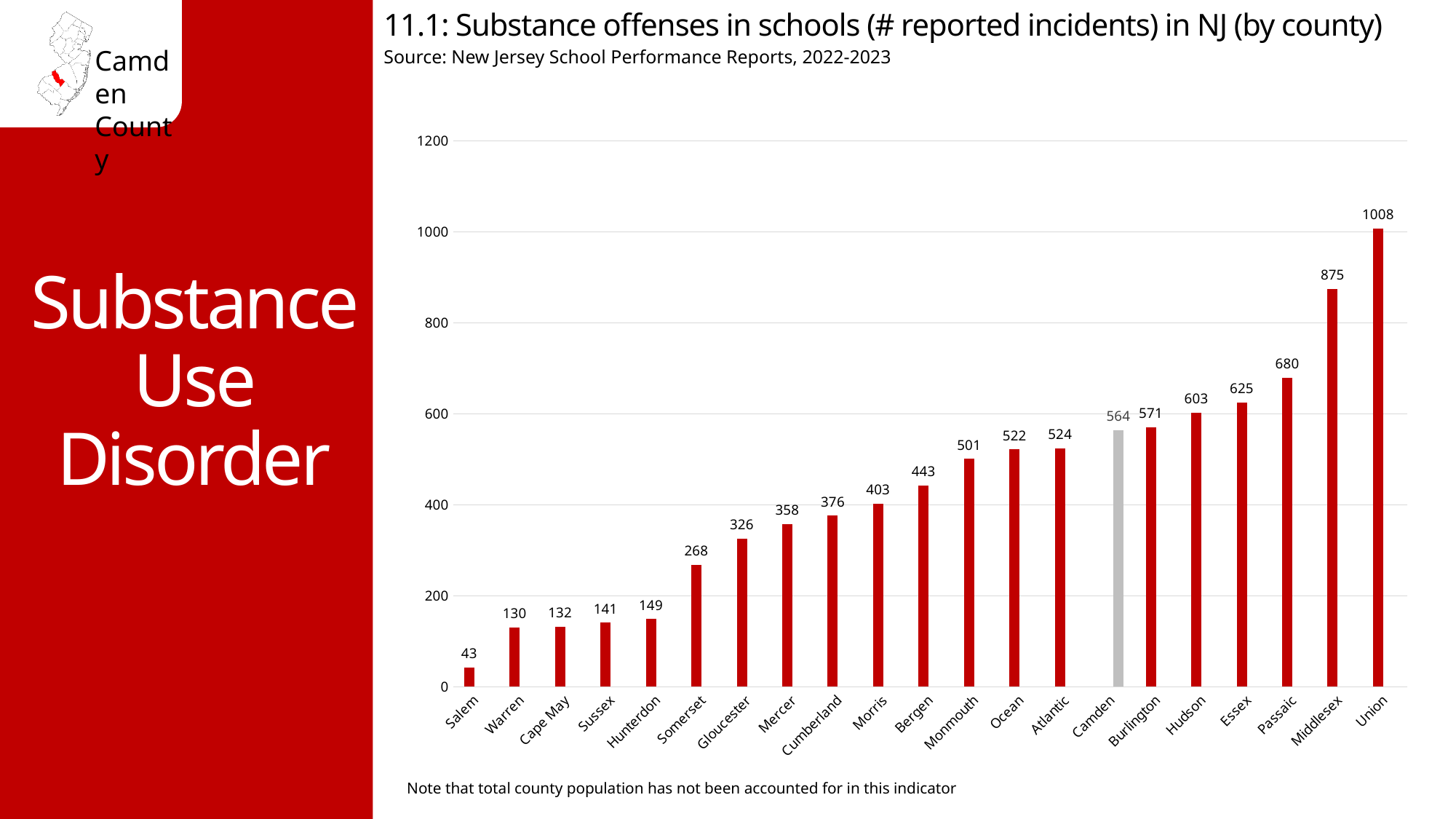
What kind of chart is shown on the slide? Bar chart How many counties are shown on the chart? 21 Is the value for Passaic greater or less than 600? greater Which county's bar is coloured grey instead of red? Camden Do the values rise or fall moving from left to right along the x axis? Rise What is the difference between the values for Camden and Burlington? 7 What is the number of reported substance offense incidents in schools for Camden county? 564 Which county has the highest number of reported incidents? Union Which county has the lowest number of reported incidents? Salem What is the value shown for Gloucester county? 326 What is the difference between the values for Union and Middlesex? 133 Which county has a larger value, Bergen or Monmouth? Monmouth